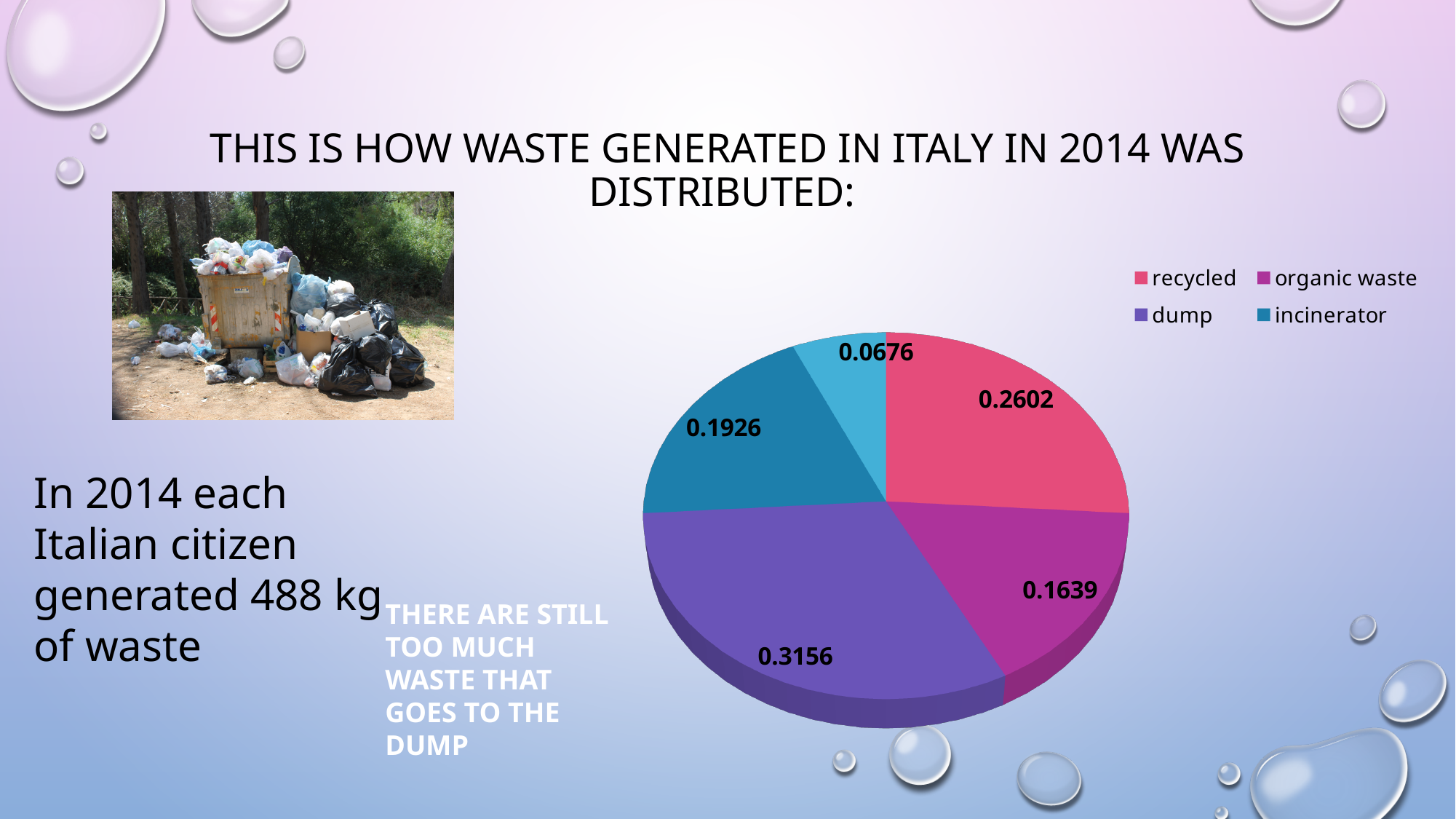
What is the difference between the recycled value and the organic waste value in the pie chart? 0.0963 What is the value shown for the recycled slice of the pie chart? 0.2602 What is the value shown for the incinerator slice of the pie chart? 0.1926 How many entries does the legend of the pie chart list? 4 What is the smallest data label shown on the pie chart? 0.0676 How many slices does the pie chart have? 5 Which is larger in the pie chart, the incinerator slice or the organic waste slice? incinerator Which category in the legend has the largest slice of the pie chart? dump What is the value shown for the organic waste slice of the pie chart? 0.1639 What type of chart is shown on the slide? pie chart What is the difference between the dump value and the recycled value in the pie chart? 0.0554 What is the value shown for the dump slice of the pie chart? 0.3156